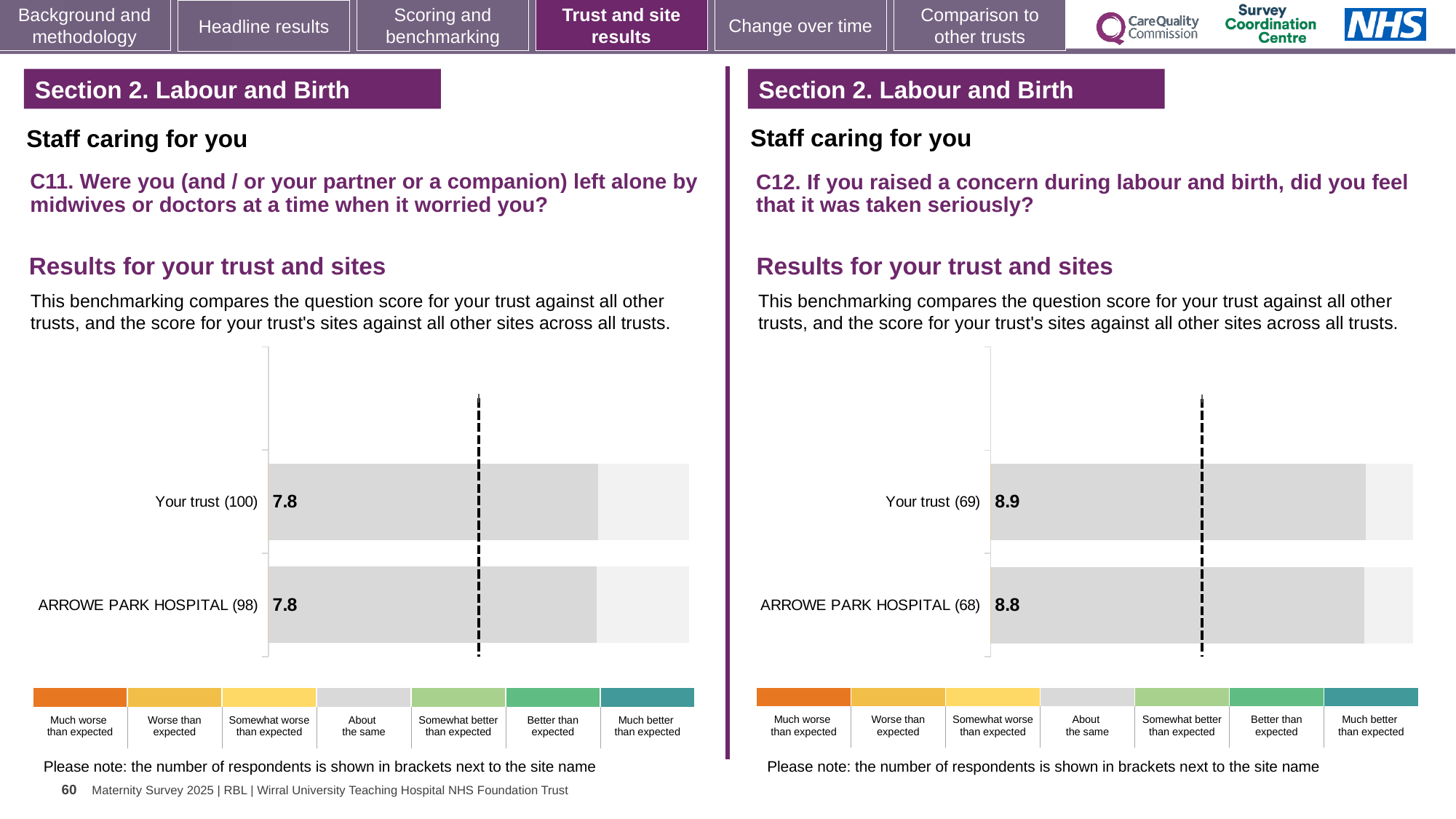
On the C12 chart (right), what is the score for Your trust? 8.9 On the C12 chart (right), which has the higher score, Your trust or ARROWE PARK HOSPITAL? Your trust On the C12 chart (right), what is the difference between the score for Your trust and the score for ARROWE PARK HOSPITAL? 0.1 How many bars are plotted on the C12 chart (right)? 2 On the C11 chart (left), what is the difference between the score for Your trust and the score for ARROWE PARK HOSPITAL? 0 How many bars are plotted on the C11 chart (left)? 2 What kind of chart is used on the C11 chart (left)? Bar chart On the C11 chart (left), what is the score for Your trust? 7.8 On the C11 chart (left), what is the score for ARROWE PARK HOSPITAL? 7.8 On the C11 chart (left), how many respondents are shown in brackets for ARROWE PARK HOSPITAL? 98 On the C12 chart (right), what is the score for ARROWE PARK HOSPITAL? 8.8 On the C12 chart (right), how many respondents are shown in brackets for Your trust? 69